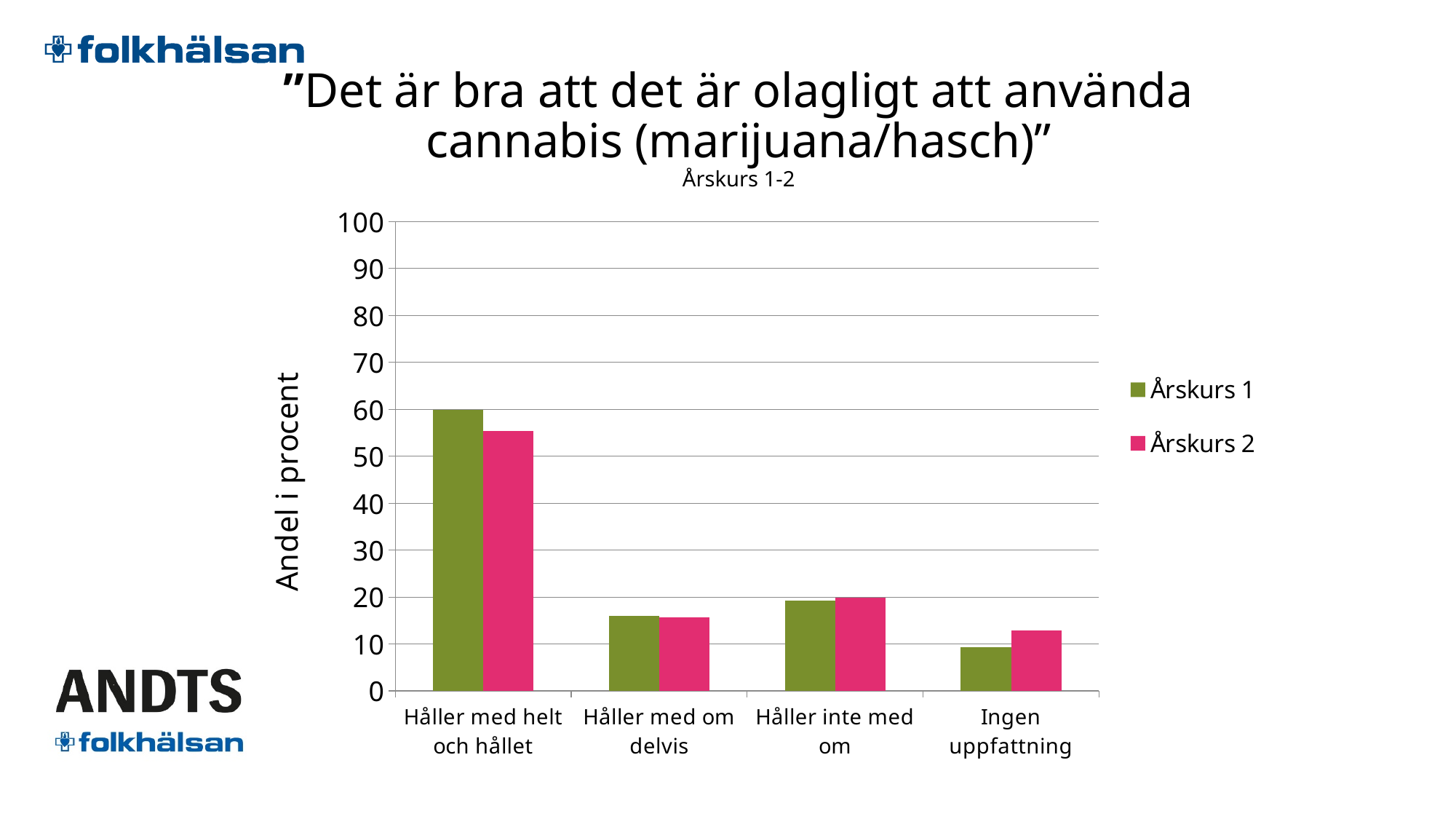
Which category has the lowest value for Årskurs 1? Ingen uppfattning How many categories are shown on the x axis? 4 For 'Ingen uppfattning', which series has the larger value, Årskurs 1 or Årskurs 2? Årskurs 2 Is the value for Årskurs 2 in 'Håller med helt och hållet' greater or less than 50? greater Which category has the highest value for Årskurs 1? Håller med helt och hållet Which category has the lowest value for Årskurs 2? Ingen uppfattning Is the value for Årskurs 1 in 'Håller med om delvis' greater or less than 20? less How many series does the legend list? 2 What kind of chart is shown on the slide? bar chart What is the label of the y axis? Andel i procent For 'Håller med helt och hållet', which series has the larger value, Årskurs 1 or Årskurs 2? Årskurs 1